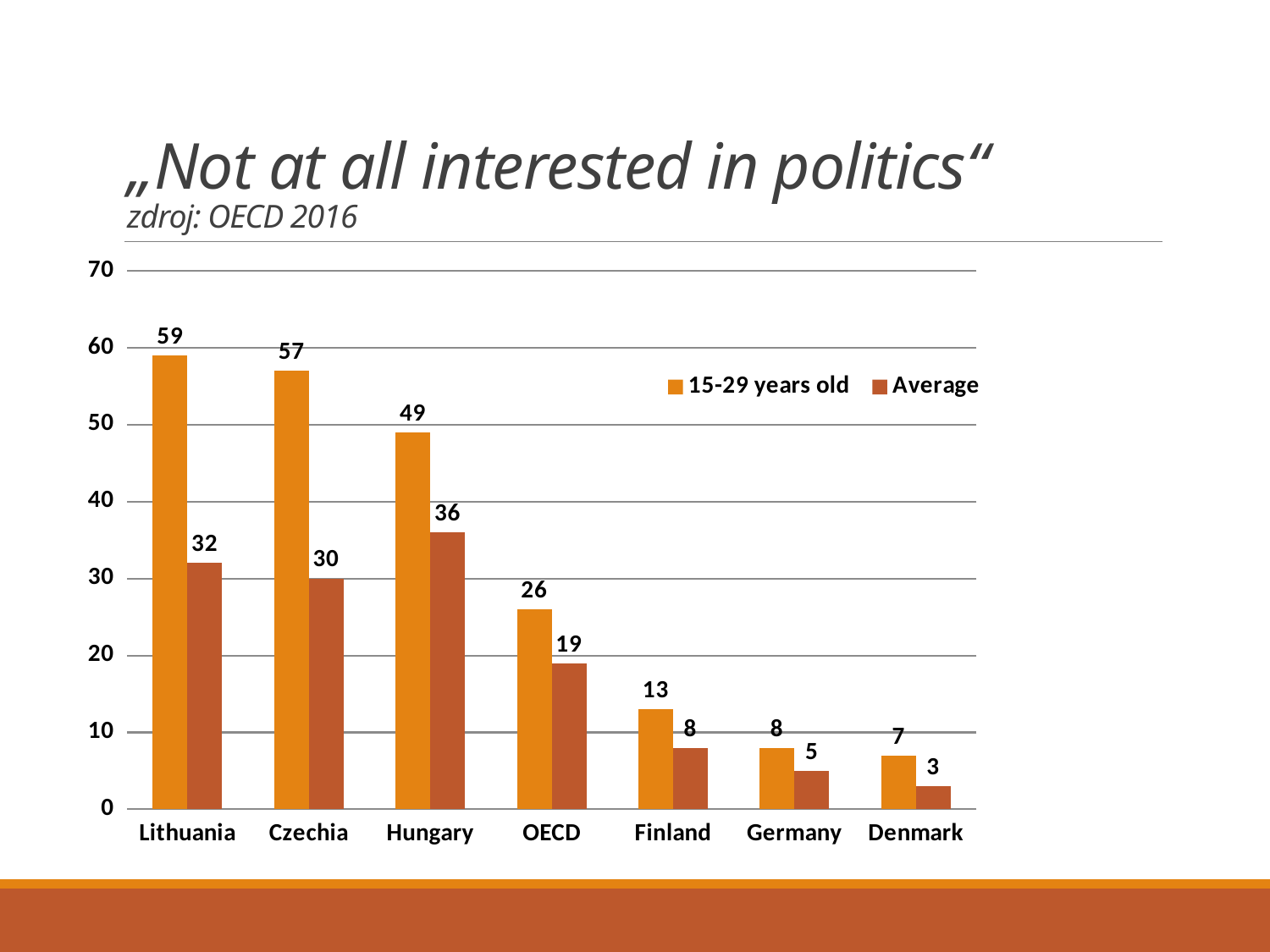
What kind of chart is shown on the slide? bar chart Which category has the lowest Average value? Denmark What is the title of the chart? „Not at all interested in politics“ How many series does the legend list? 2 What is the value for 15-29 years old in Finland? 13 Which category has the highest value for 15-29 years old? Lithuania What is the Average value for Hungary? 36 How many categories are shown on the x axis? 7 What is the difference between the 15-29 years old value and the Average value for Lithuania? 27 Do the 15-29 years old values rise or fall from Lithuania to Denmark along the x axis? fall What is the value for 15-29 years old in Czechia? 57 Which is larger: the Average value for Czechia or the Average value for Hungary? Hungary